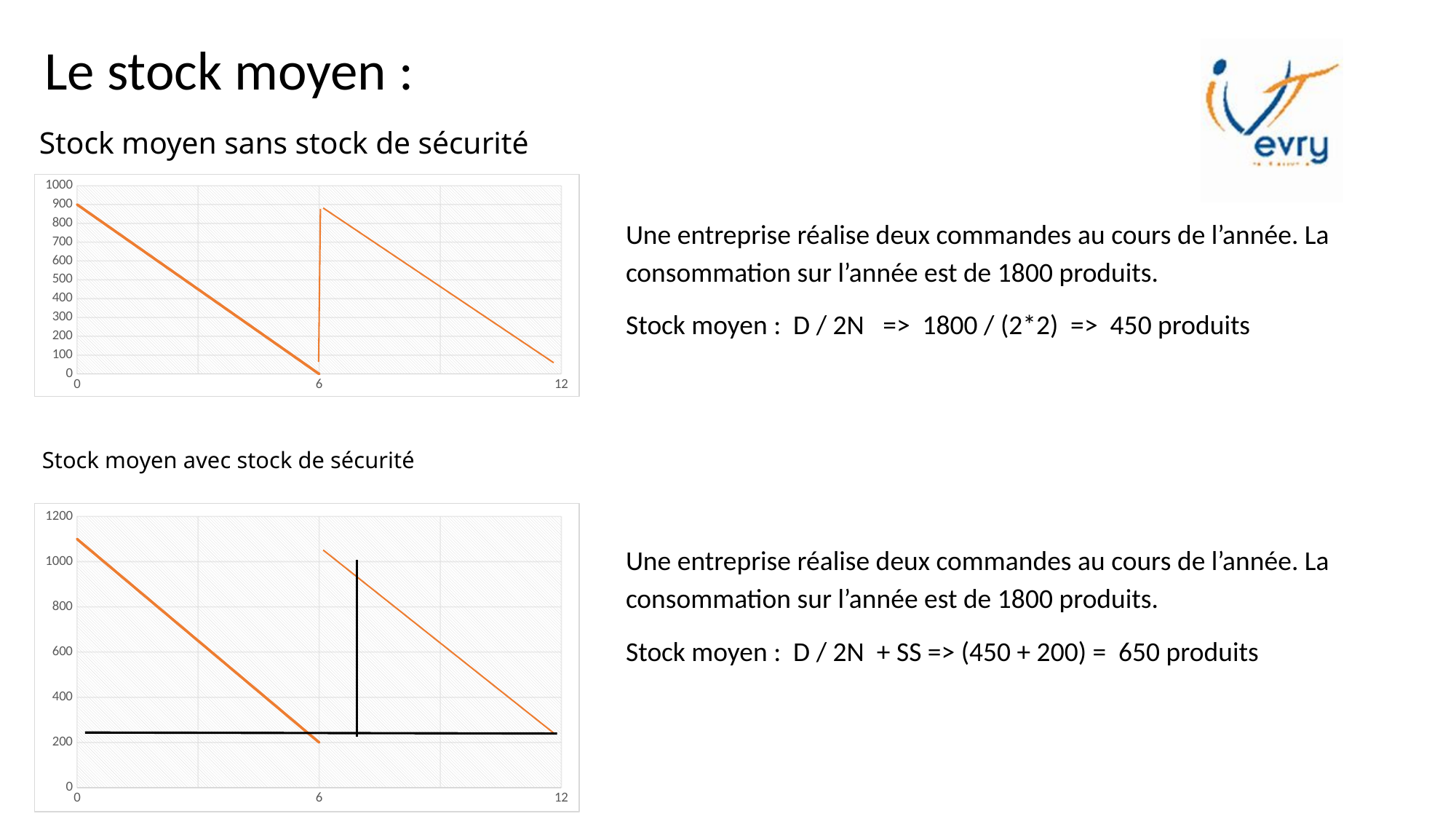
What is the highest value shown on the y axis of the top chart, 'Stock moyen sans stock de sécurité'? 1000 In the bottom chart, 'Stock moyen avec stock de sécurité', is the value at x = 0 greater or less than 1000? greater In the bottom chart, 'Stock moyen avec stock de sécurité', is the value of the orange line at x = 12 greater or less than 400? less What is the highest value shown on the y axis of the bottom chart, 'Stock moyen avec stock de sécurité'? 1200 In the top chart, 'Stock moyen sans stock de sécurité', is the value just before x = 6 greater or less than 100? less What kind of chart is the top chart, 'Stock moyen sans stock de sécurité'? line chart In the top chart, 'Stock moyen sans stock de sécurité', does the stock level rise or fall between x = 0 and x = 6? fall What kind of chart is the bottom chart, 'Stock moyen avec stock de sécurité'? line chart In the top chart, 'Stock moyen sans stock de sécurité', which is larger: the value at x = 0 or the value just before x = 6? the value at x = 0 In the bottom chart, 'Stock moyen avec stock de sécurité', does the orange line rise or fall between x = 6 and x = 12? fall How many tick labels are shown on the x axis of the bottom chart, 'Stock moyen avec stock de sécurité'? 3